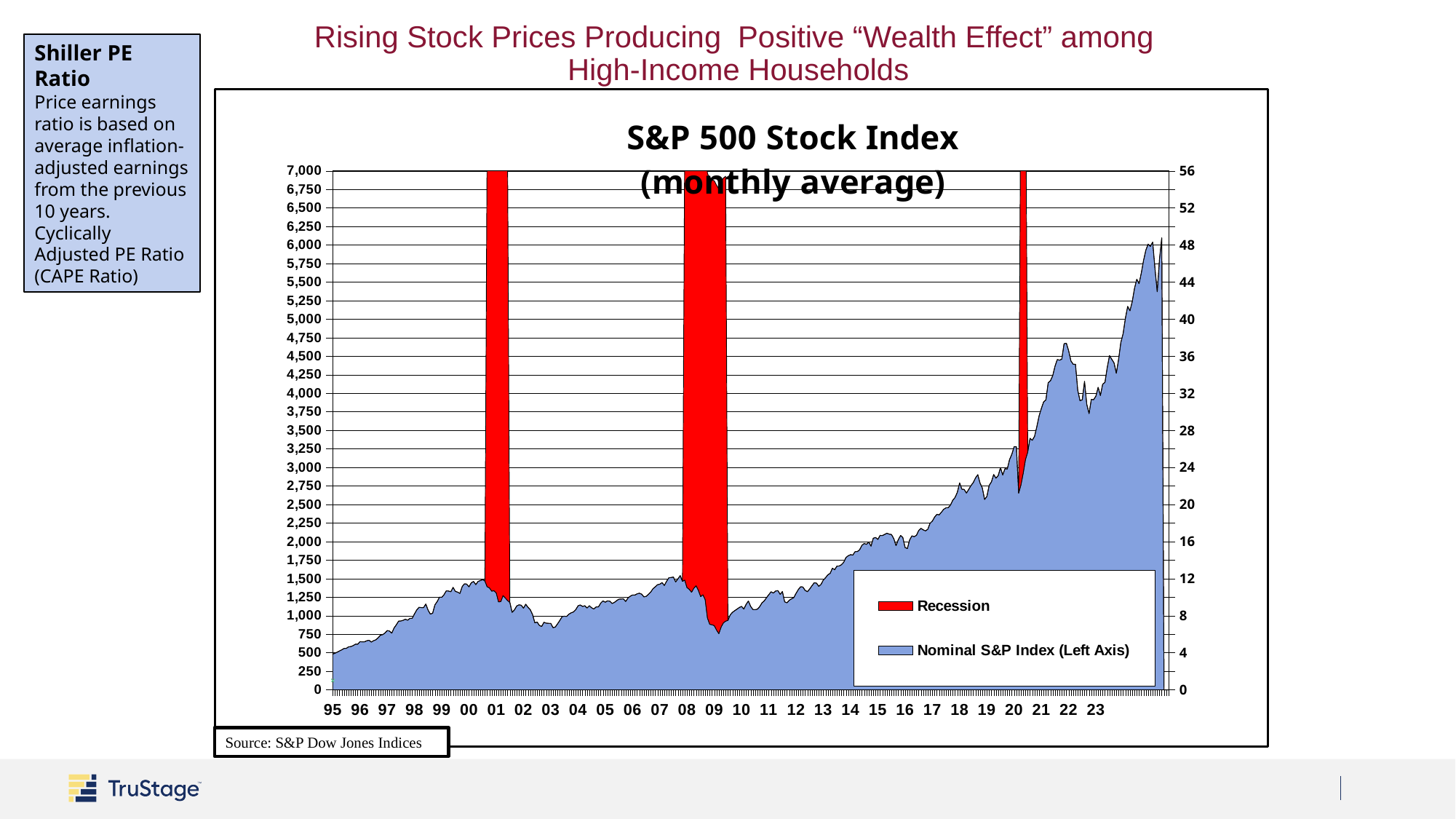
Overall, does the Nominal S&P Index rise or fall from 1995 to the end of the chart? Rises Is the highest Nominal S&P Index value at the right end of the chart greater or less than 5,000? greater Which is larger, the Nominal S&P Index value in 2000 or in 2021? 2021 Is the Nominal S&P Index value in 2018 greater or less than 2,000? greater Is the peak Nominal S&P Index value around 2000 greater or less than 1,750? less How many recession periods are shaded in red on the chart? 3 What kind of chart is shown on the slide? Area chart What is the highest value shown on the left axis of the chart? 7,000 What is the title of the chart? S&P 500 Stock Index (monthly average) How many entries does the chart's legend list? 2